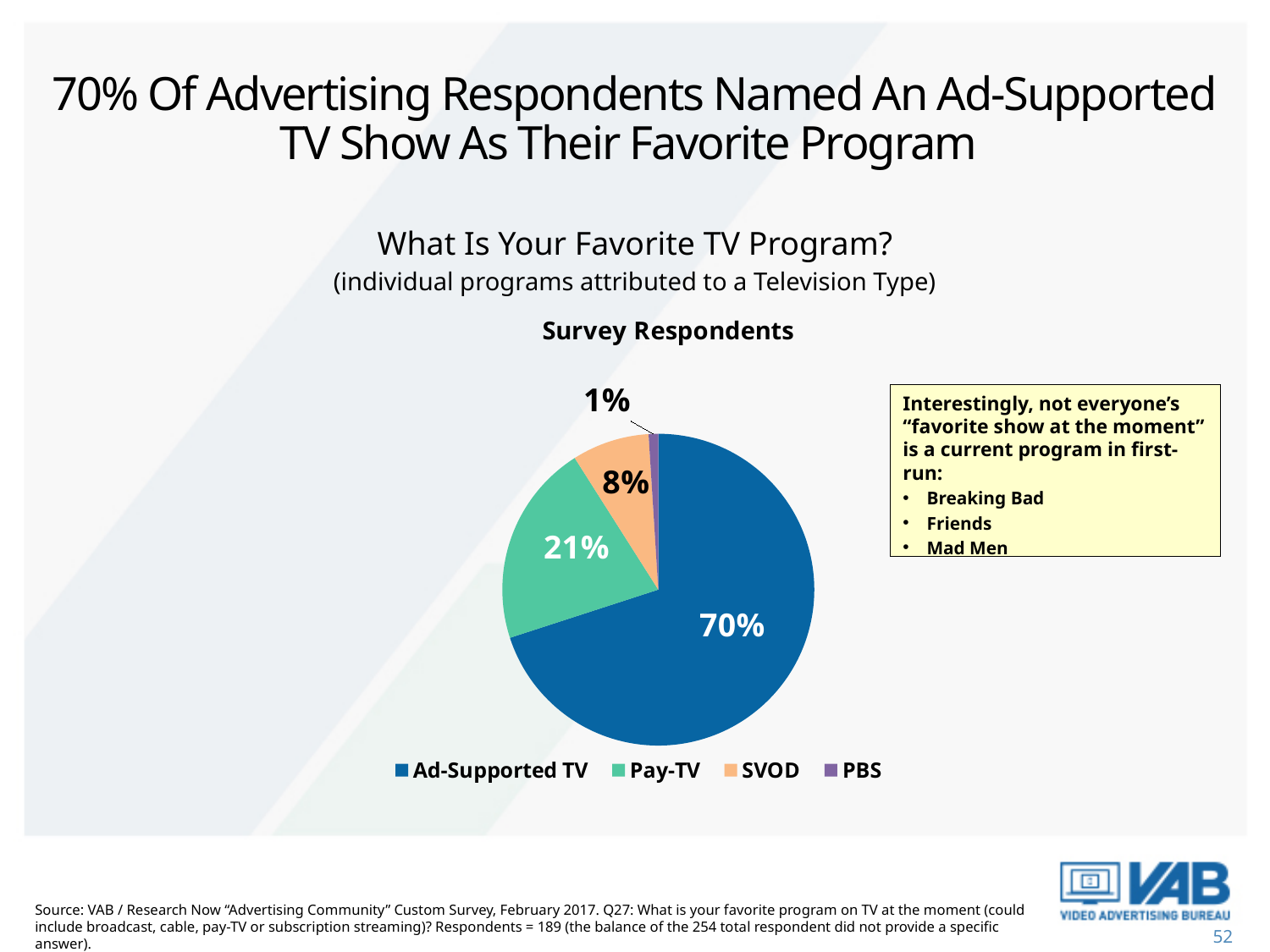
What percentage of respondents is attributed to Pay-TV? 21% Which is larger, the Pay-TV slice or the SVOD slice? Pay-TV What is the difference in percentage points between Ad-Supported TV and Pay-TV? 49 What percentage of respondents is attributed to SVOD? 8% Which television type has the smallest slice of the pie? PBS What type of chart is shown on the slide? pie chart What is the title of the chart? Survey Respondents Which television type has the largest slice of the pie? Ad-Supported TV What share of survey respondents named an Ad-Supported TV program as their favorite? 70% How many television types are shown in the pie chart? 4 What percentage of respondents is attributed to PBS? 1% What colour is the Pay-TV slice in the pie chart? green